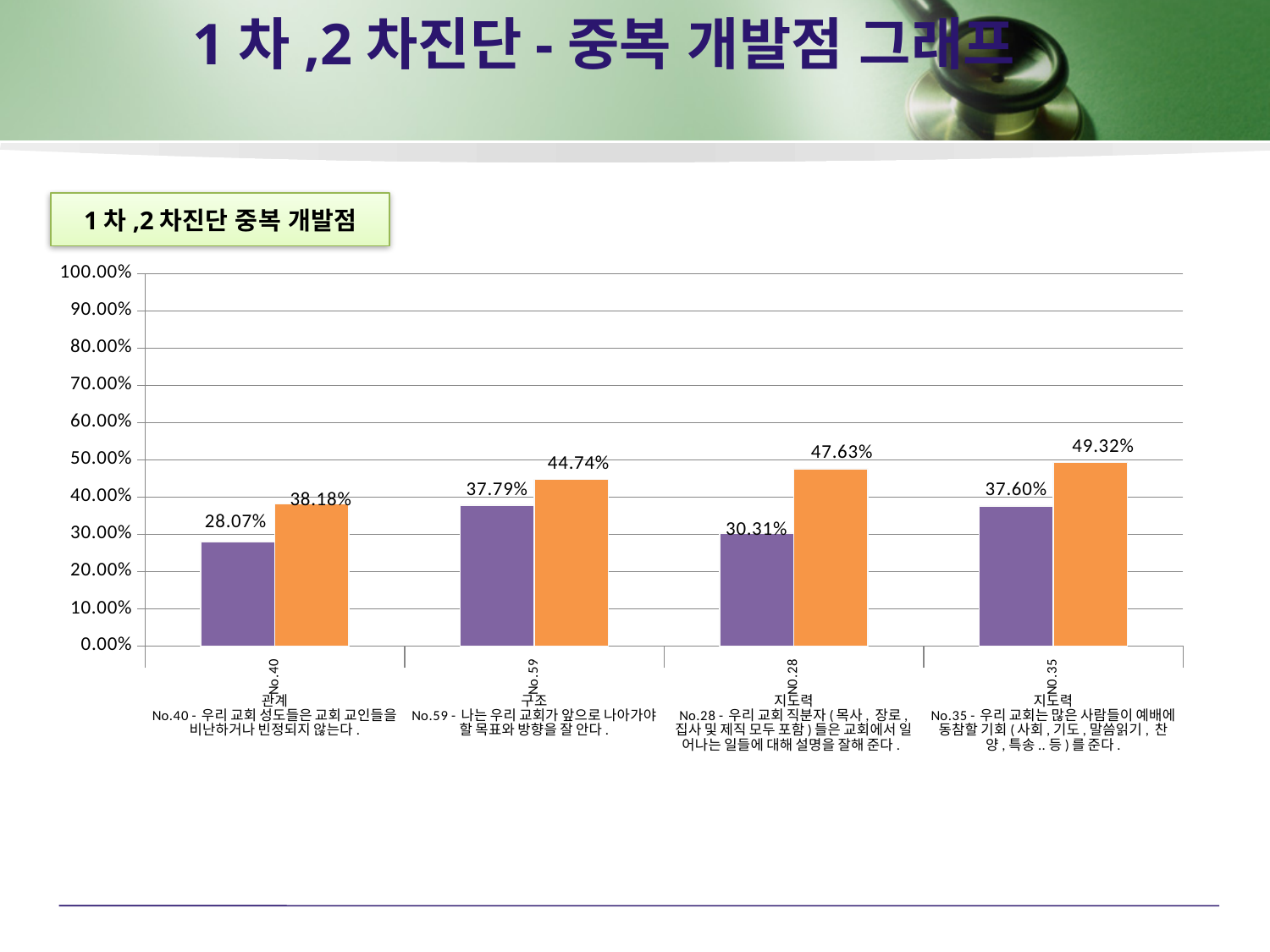
What is the value of the orange bar for No.35? 49.32% What is the value of the purple bar for No.28? 30.31% Is the orange bar for No.40 greater or less than 40.00%? less What is the difference between the orange and purple bars for No.28? 17.32% How many categories are shown on the x axis of the chart? 4 Which category has the lowest purple bar? No.40 What is the value of the orange bar for No.59? 44.74% What is the maximum value shown on the y axis of the chart? 100.00% What type of chart is shown on the slide? bar chart Which is larger, the purple bar for No.59 or the purple bar for No.28? No.59 What is the value of the purple bar for No.40? 28.07% Which category has the highest orange bar? No.35